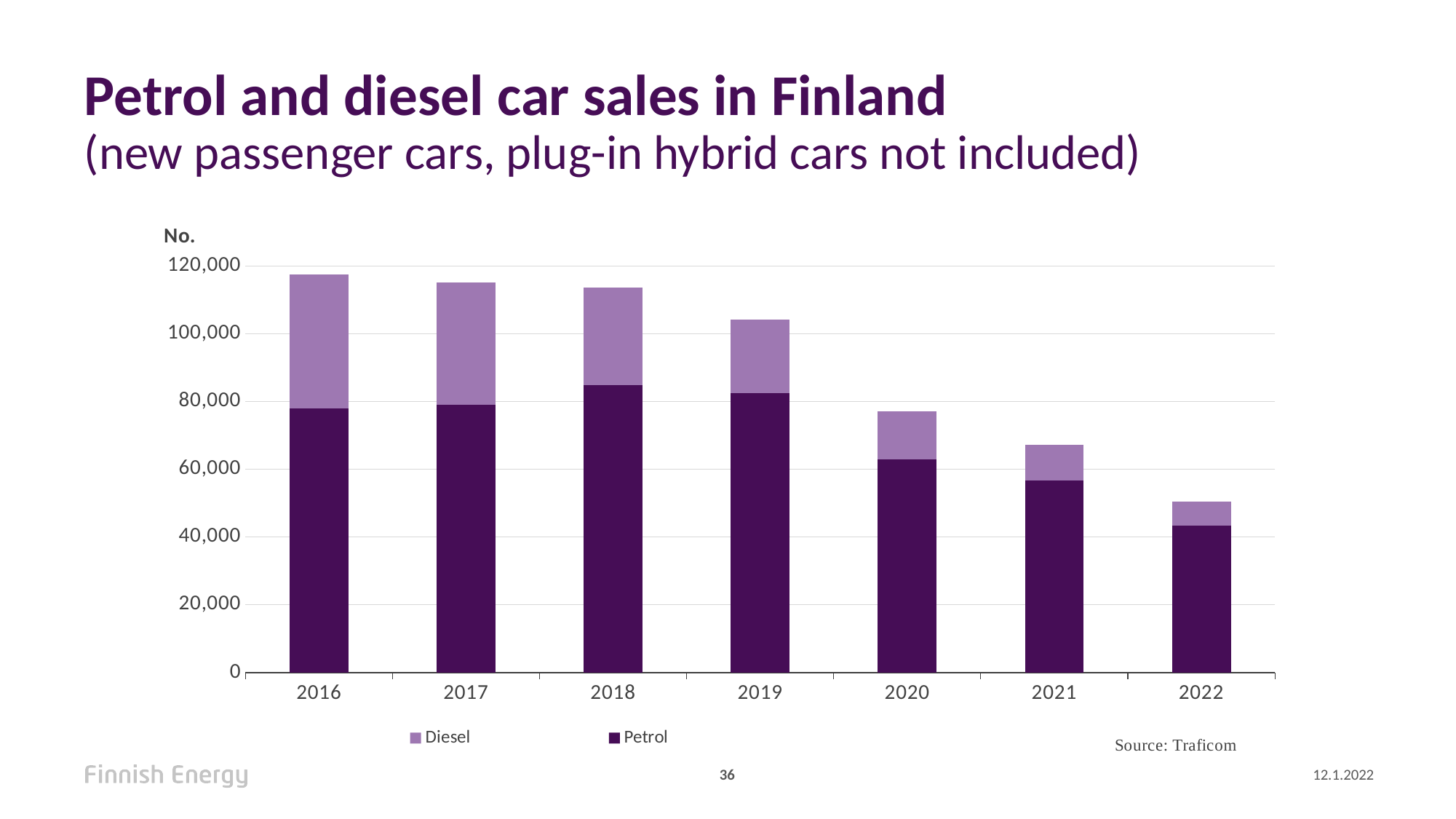
Is the value for Petrol in 2020 greater or less than 60,000? greater Which year has the larger total of petrol and diesel car sales, 2016 or 2020? 2016 Do total petrol and diesel car sales rise or fall from 2016 to 2022? Fall Is the total of petrol and diesel car sales in 2016 greater or less than 100,000? greater What is the source cited for the chart data? Traficom Which year has the lowest petrol car sales? 2022 Which two series are listed in the chart's legend? Diesel and Petrol How many years are shown on the x axis of the chart? 7 Is the total of petrol and diesel car sales in 2022 greater or less than 60,000? less Which year has the lowest total of petrol and diesel car sales? 2022 How many series does the chart's legend list? 2 What kind of chart is shown on the slide? Stacked bar chart